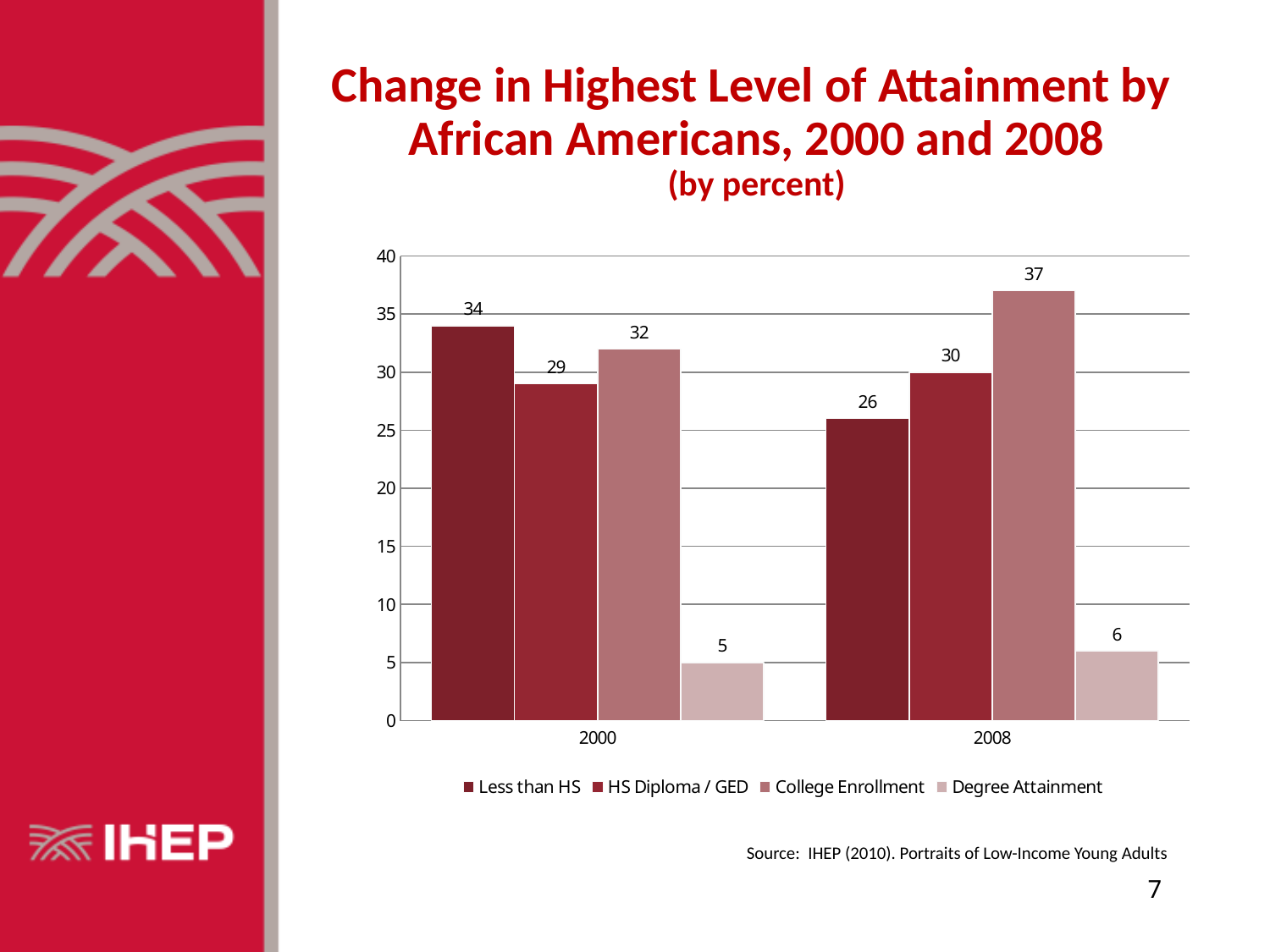
What is the value for Degree Attainment in 2000? 5 What is the value for HS Diploma / GED in 2008? 30 What is the value for College Enrollment in 2008? 37 Which series has the highest value in 2008? College Enrollment What is the difference between the Less than HS values for 2000 and 2008? 8 Does the Less than HS value rise or fall from 2000 to 2008? Fall How many year categories are shown on the x axis? 2 How many series does the legend list? 4 Which is larger, College Enrollment in 2000 or College Enrollment in 2008? College Enrollment in 2008 What kind of chart is shown on the slide? Bar chart What is the value for Less than HS in 2000? 34 Which series has the lowest value in 2000? Degree Attainment